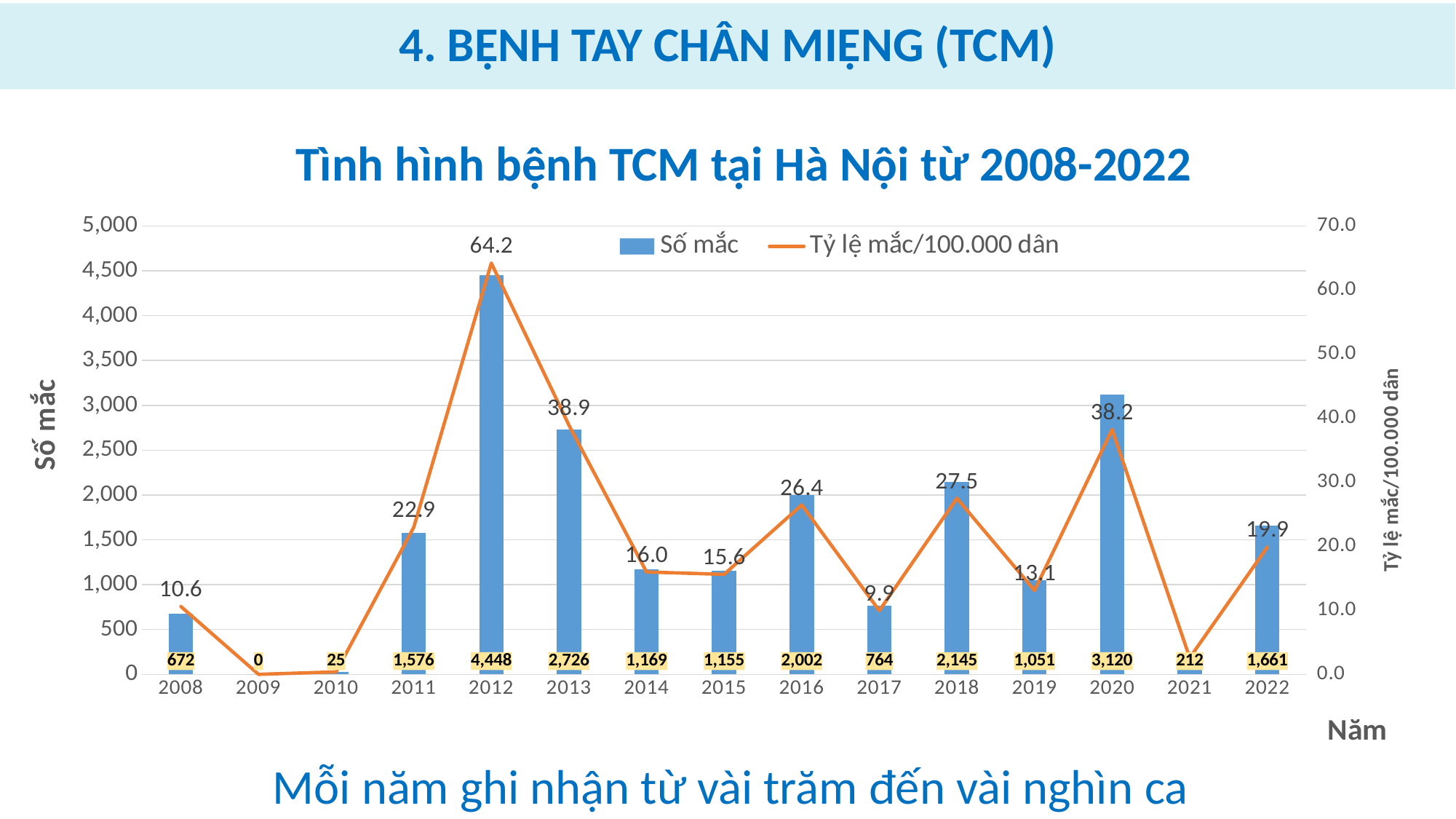
What is the value of Tỷ lệ mắc/100.000 dân for 2020? 38.2 Which year has the highest Số mắc? 2012 What is the value of Số mắc for 2012? 4,448 What is the title of the chart? Tình hình bệnh TCM tại Hà Nội từ 2008-2022 Which year has the lowest Số mắc? 2009 What kind of chart is this? Combined bar and line chart Is the Số mắc value for 2016 greater or less than 1,500? greater Which year has the larger Số mắc, 2013 or 2018? 2013 What is the value of Số mắc for 2021? 212 What is the difference in Số mắc between 2020 and 2022? 1,459 How many series does the legend list? 2 How many years are shown on the x axis? 15